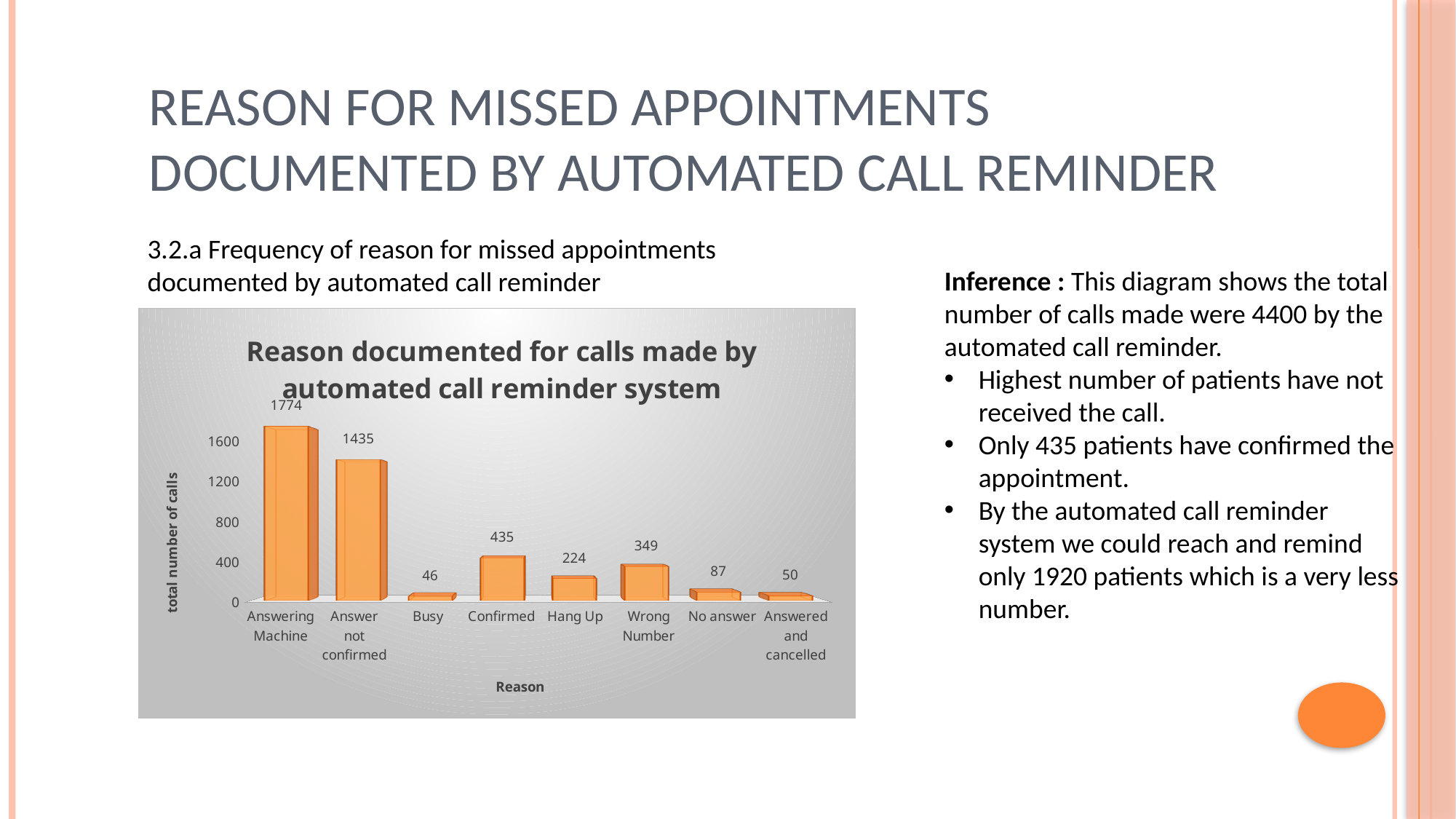
Is the value for Confirmed greater or less than 400? greater How many categories are shown on the x axis? 8 What is the difference between Answering Machine and Answer not confirmed? 339 What is the value for Answering Machine? 1774 What is the value for Answered and cancelled? 50 What is the value for Confirmed? 435 Which is larger, Hang Up or Wrong Number? Wrong Number Which category has the lowest value? Busy Which category has the highest value? Answering Machine What is the value for Wrong Number? 349 What kind of chart is this? bar chart What is the title of the chart? Reason documented for calls made by automated call reminder system